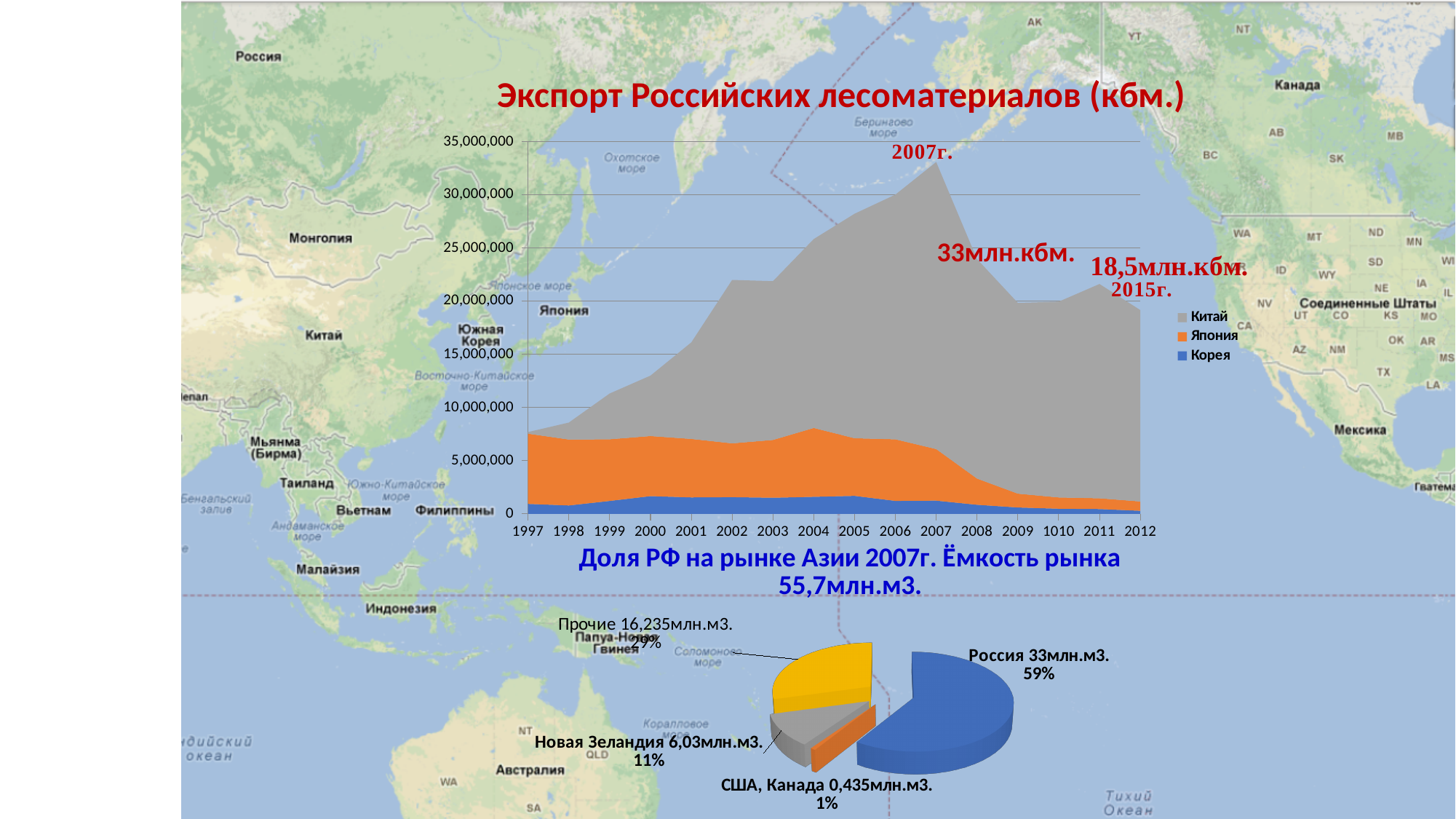
In the top chart 'Экспорт Российских лесоматериалов (кбм.)', is the total export value for 2007 greater or less than 30,000,000? greater What kind of chart is the bottom chart titled 'Доля РФ на рынке Азии 2007г.'? pie chart In the top chart 'Экспорт Российских лесоматериалов (кбм.)', how many series does the legend list? 3 In the top chart 'Экспорт Российских лесоматериалов (кбм.)', is the total export value for 1997 greater or less than 10,000,000? less In the top chart 'Экспорт Российских лесоматериалов (кбм.)', does the total export rise or fall between 2007 and 2009? fall In the top chart 'Экспорт Российских лесоматериалов (кбм.)', which series is shown in orange? Япония In the bottom pie chart 'Доля РФ на рынке Азии 2007г.', what share does Россия hold? 59% In the bottom pie chart 'Доля РФ на рынке Азии 2007г.', what is the value for Новая Зеландия? 6,03млн.м3. What kind of chart is the top chart titled 'Экспорт Российских лесоматериалов (кбм.)'? area chart In the top chart 'Экспорт Российских лесоматериалов (кбм.)', what export volume is annotated for 2015г.? 18,5млн.кбм. In the bottom pie chart 'Доля РФ на рынке Азии 2007г.', how many slices are there? 4 In the bottom pie chart 'Доля РФ на рынке Азии 2007г.', which slice is the smallest? США, Канада